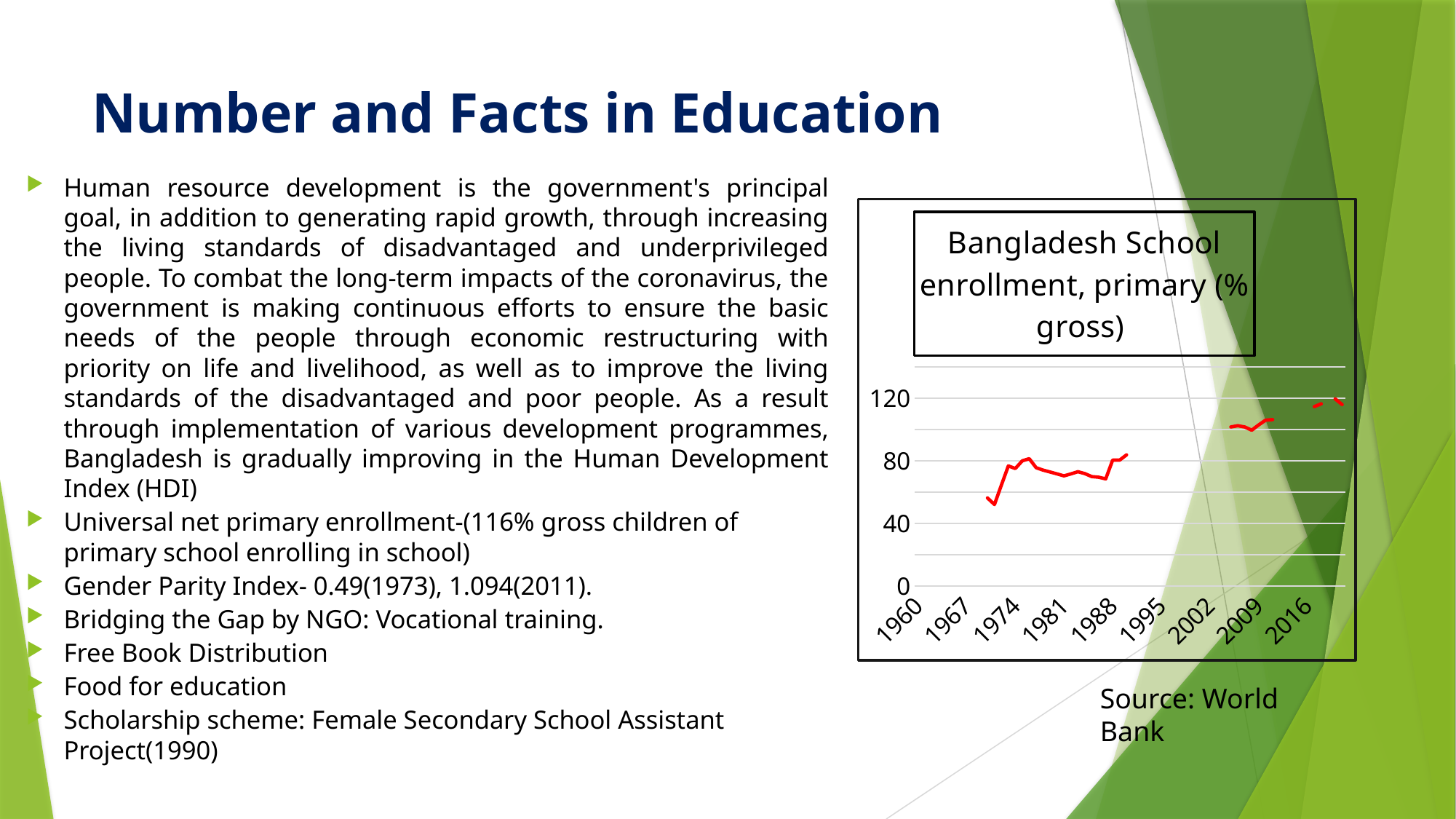
Is the value for 1974 greater or less than 120? less Is the value for 2009 greater or less than 80? greater Is the value for 1981 greater or less than 40? greater What source is cited below the chart? World Bank How many year labels are shown on the x axis of the chart? 9 What is the highest tick value shown on the y axis? 120 What kind of chart is shown on the slide? line chart What is the first year label on the x axis? 1960 Which year has the larger value, 1981 or 2009? 2009 Overall, do the plotted values rise or fall from the 1970s to 2016? rise What is the title of the chart? Bangladesh School enrollment, primary (% gross)